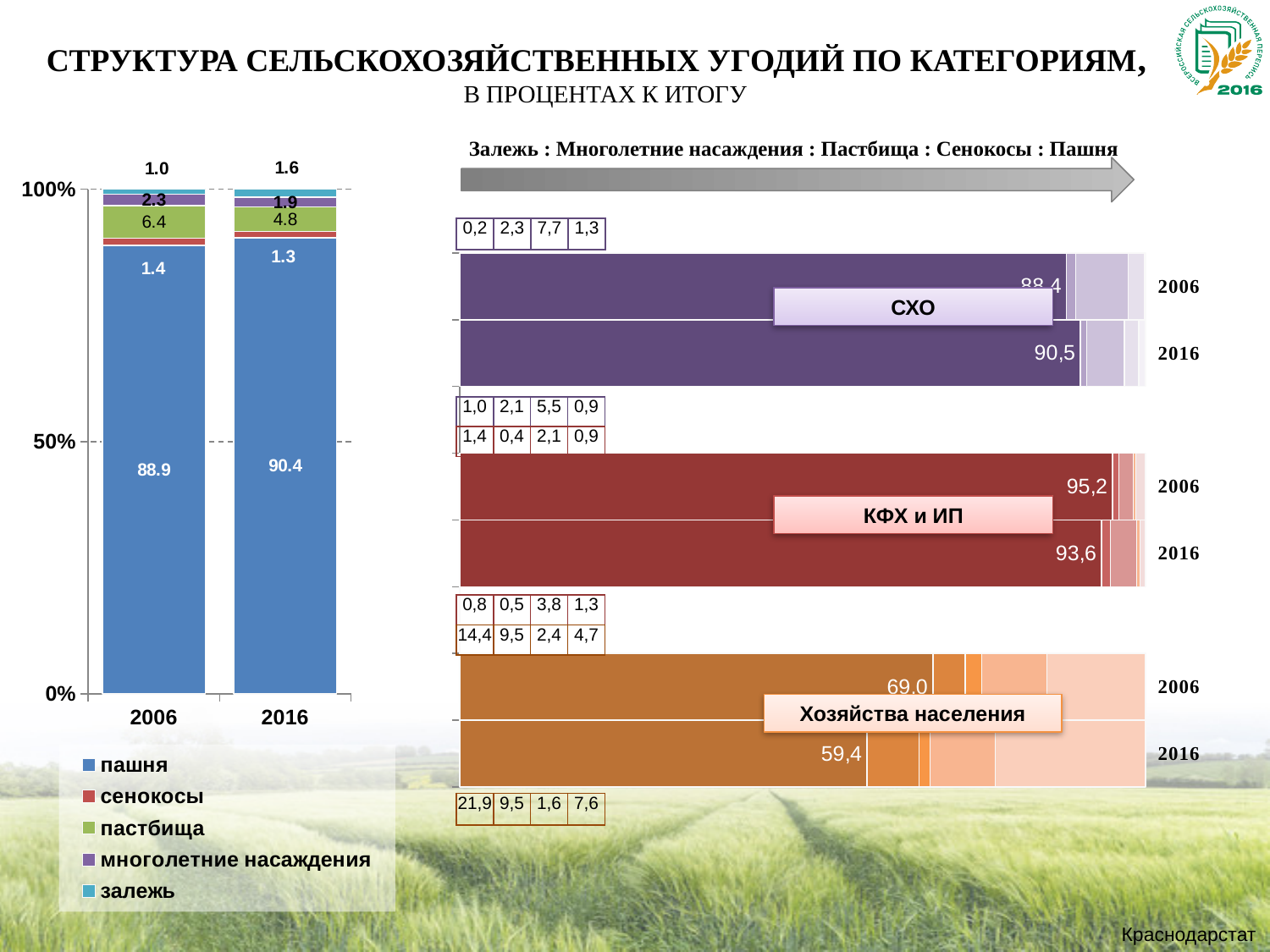
In the stacked bar chart on the left, is the value for пастбища larger in 2006 or in 2016? 2006 In the stacked bar chart on the left, what is the value for пастбища in 2006? 6.4 What kind of chart is shown on the left of the slide? stacked bar chart In the stacked bar chart on the left, what is the value for залежь in 2016? 1.6 In the horizontal bar chart on the right, what is the value for the largest segment of Хозяйства населения in 2016? 59,4 In the horizontal bar chart on the right, what is the value for the largest segment of КФХ и ИП in 2006? 95,2 In the horizontal bar chart on the right, what is the value for the largest segment of СХО in 2016? 90,5 In the stacked bar chart on the left, what is the value for пашня in 2016? 90.4 How many series does the legend of the stacked bar chart on the left list? 5 In the stacked bar chart on the left, by how much did the value for пашня change from 2006 to 2016? 1.5 In the stacked bar chart on the left, what is the value for многолетние насаждения in 2006? 2.3 In the stacked bar chart on the left, which category has the largest share in 2016? пашня